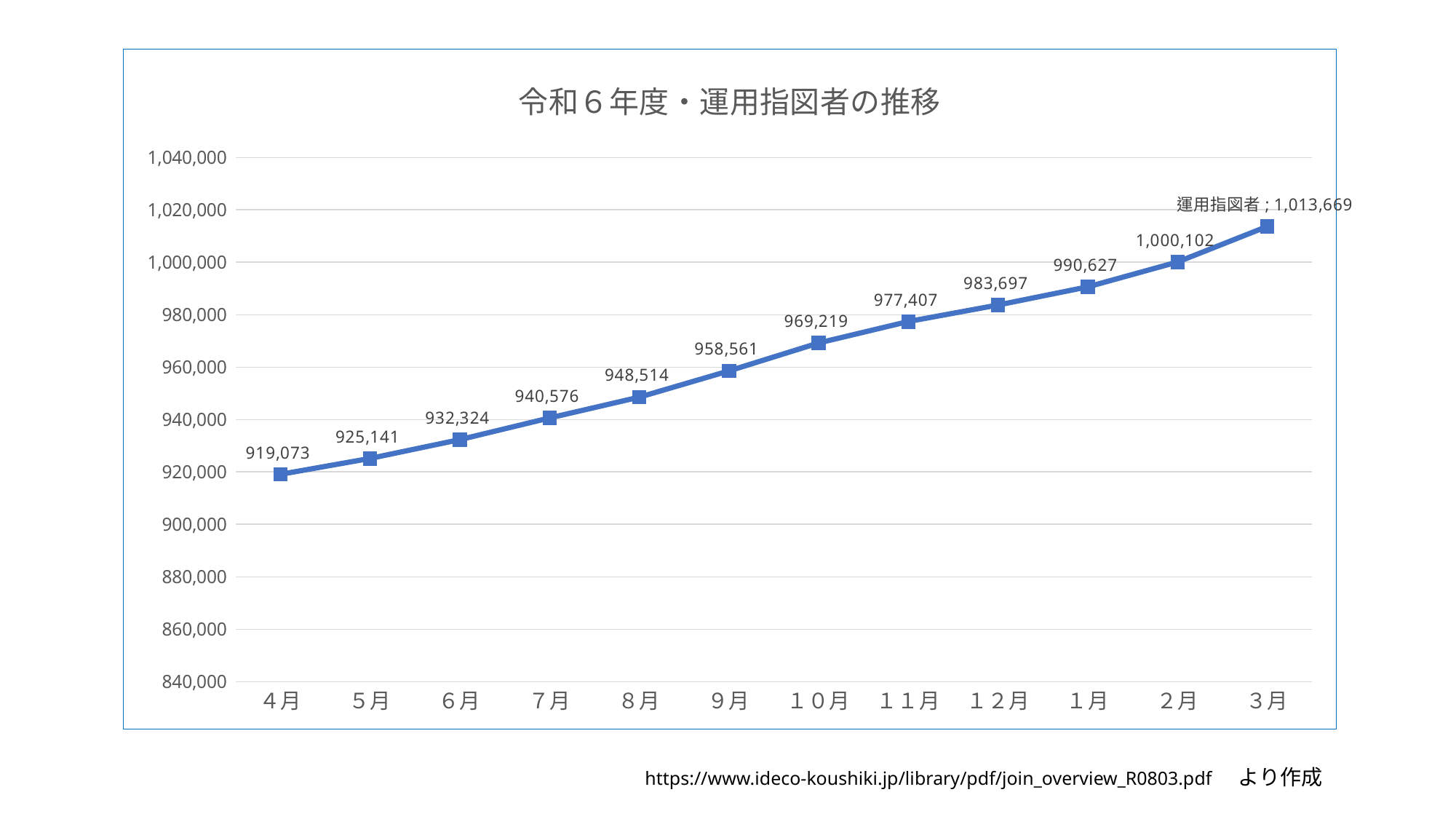
How many months are plotted on the x axis? 12 Which month has the highest value? 3月 What is the difference between the values for 2月 and 1月? 9,475 What is the difference between the values for 3月 and 4月? 94,596 What is the value for 4月? 919,073 What type of chart is shown on the slide? line chart What is the title of the chart? 令和６年度・運用指図者の推移 Is the value for 11月 greater or less than 1,000,000? less Which month has the lowest value? 4月 What is the value for 3月? 1,013,669 Which is larger, the value for 8月 or the value for 9月? 9月 What is the value for 10月? 969,219